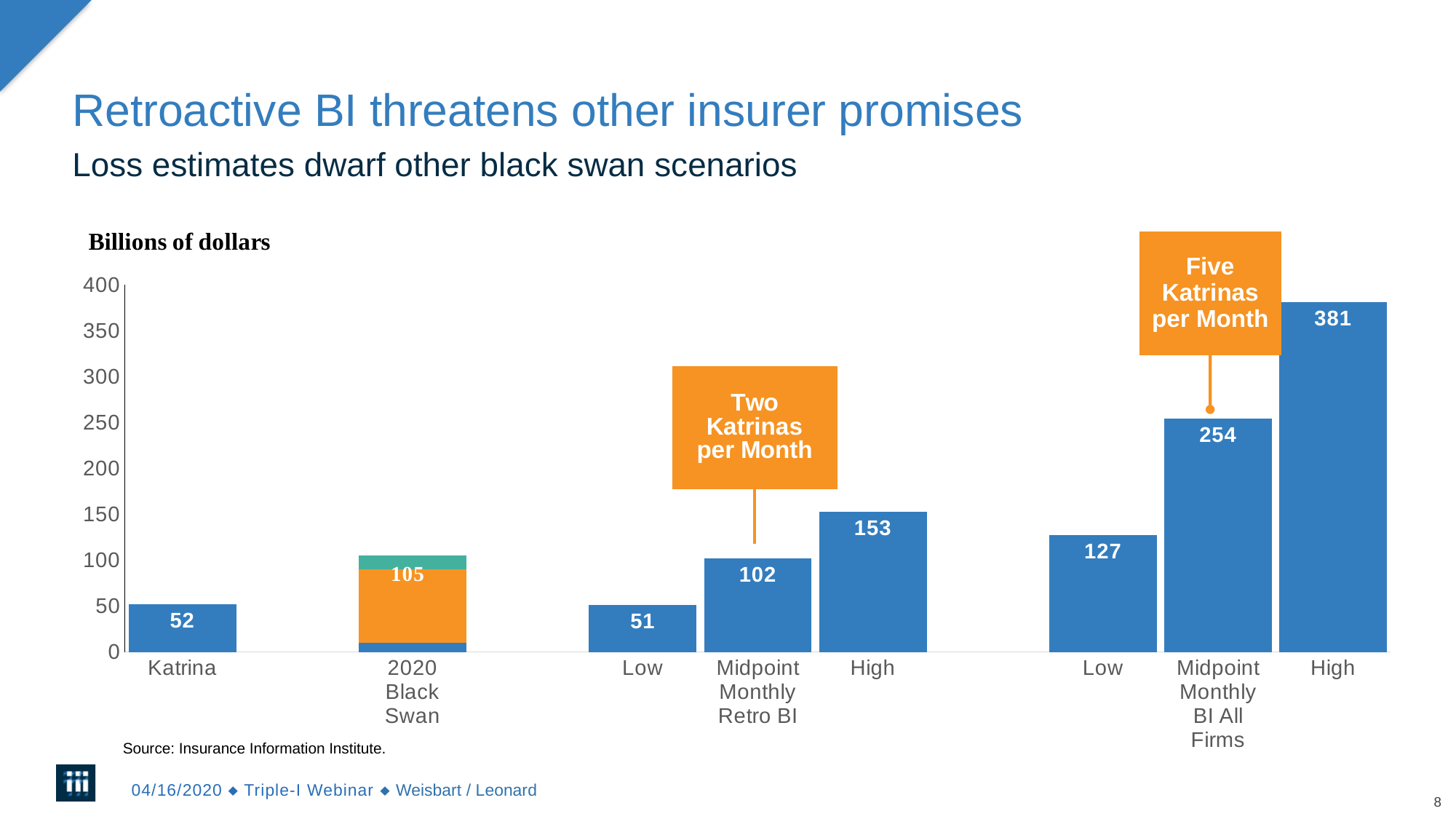
What is the value for the High bar in the Monthly BI All Firms group? 381 Which is larger, the Midpoint Monthly Retro BI bar or the Low bar in the Monthly BI All Firms group? Low (Monthly BI All Firms) What kind of chart is shown on the slide? Bar chart What is the difference between the High and Midpoint bars in the Monthly BI All Firms group? 127 What is the value labeled on the 2020 Black Swan bar? 105 Which category has the highest value? High (Monthly BI All Firms) How many bars are plotted in the chart? 8 What unit is stated above the y axis? Billions of dollars Which category has the lowest value? Low (Monthly Retro BI) What is the value for the Midpoint Monthly Retro BI bar? 102 What is the value for Katrina? 52 Is the value for Midpoint Monthly BI All Firms greater or less than 200? greater